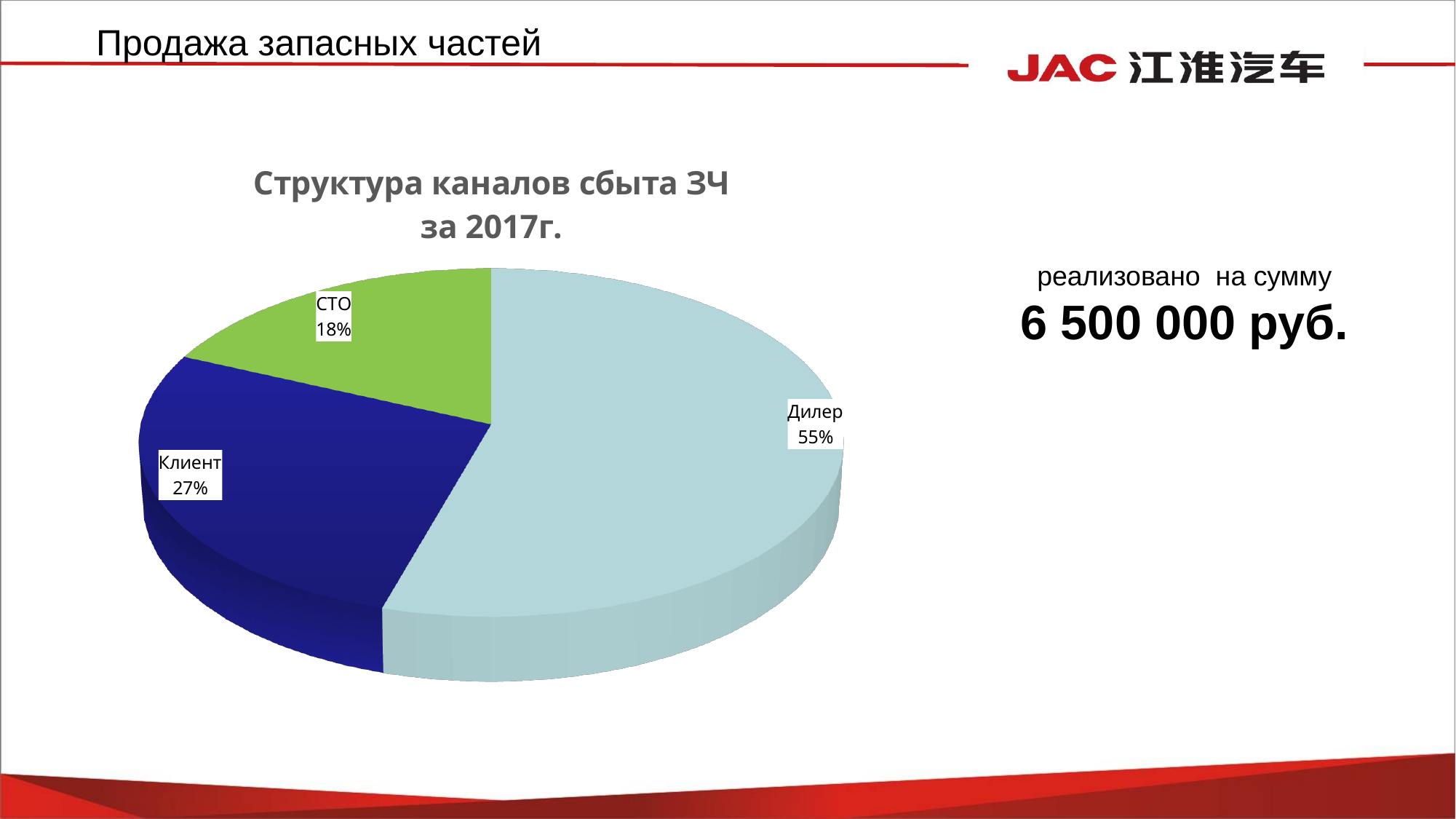
What is the title of the chart? Структура каналов сбыта ЗЧ за 2017г. What share of the pie does Клиент have? 27% What share of the pie does СТО have? 18% What is the difference in percentage points between the Клиент and СТО slices? 9 What colour is the Дилер slice? Light blue What kind of chart is shown on the slide? Pie chart Which slice is larger, Клиент or СТО? Клиент How many slices does the pie chart have? 3 What share of the pie does Дилер have? 55% Which category has the largest slice of the pie? Дилер What is the difference in percentage points between the Дилер and Клиент slices? 28 Which category has the smallest slice of the pie? СТО